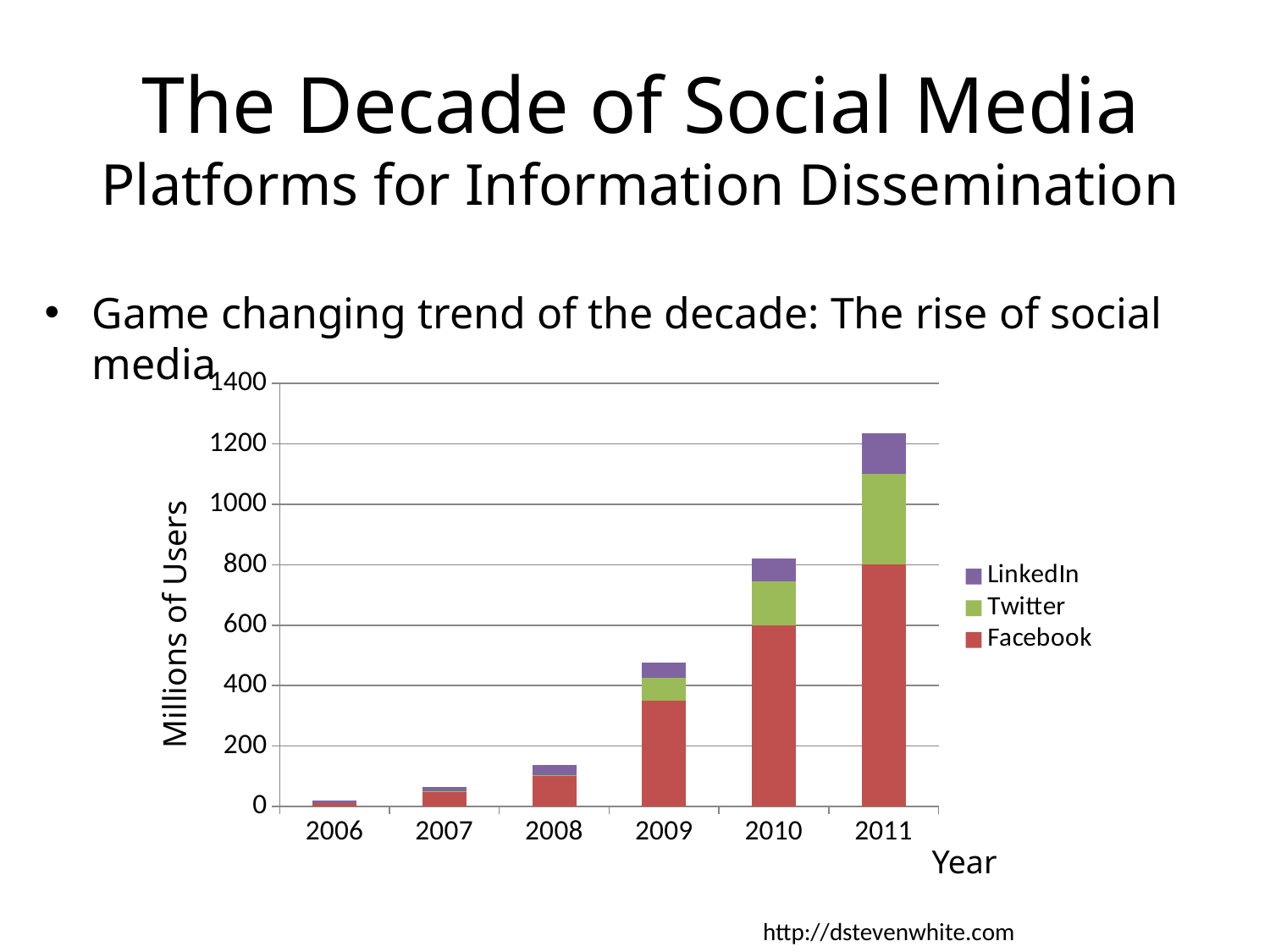
Which series is shown in red in the chart's legend? Facebook What is the label on the vertical axis of the chart? Millions of Users Which year has the tallest stacked bar in the chart? 2011 How many years are shown on the x axis of the chart? 6 What kind of chart is shown on the slide? stacked bar chart Is the total stacked bar for 2011 greater or less than 1200? greater Do the total stacked bar heights rise or fall from 2006 to 2011? rise Which is larger, the total stacked bar for 2008 or for 2009? 2009 How many series does the chart's legend list? 3 Which year has the shortest stacked bar in the chart? 2006 Is the total stacked bar for 2009 greater or less than 600? less